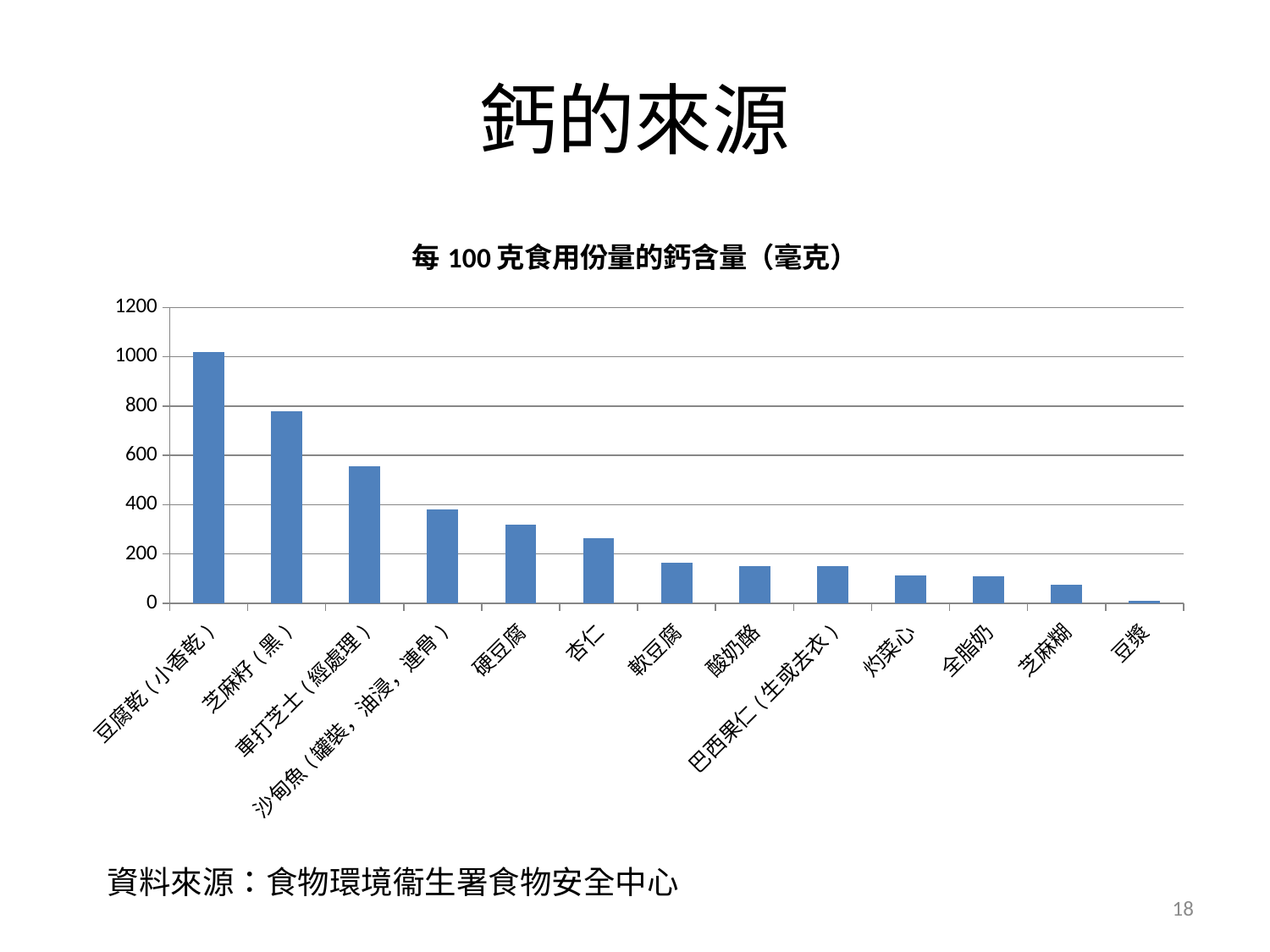
Is the value for 車打芝士（經處理） greater or less than 400? greater What kind of chart is shown on the slide? bar chart Which food has the lowest calcium content in the chart? 豆漿 How many food categories are plotted in the chart? 13 What is the title of the chart? 每 100 克食用份量的鈣含量（毫克） Is the value for 軟豆腐 greater or less than 200? less Which has a higher calcium content, 硬豆腐 or 杏仁? 硬豆腐 Do the bar values rise or fall from left to right along the x axis? fall Is the value for 豆腐乾（小香乾） greater or less than 800? greater Which food has the highest calcium content in the chart? 豆腐乾（小香乾）